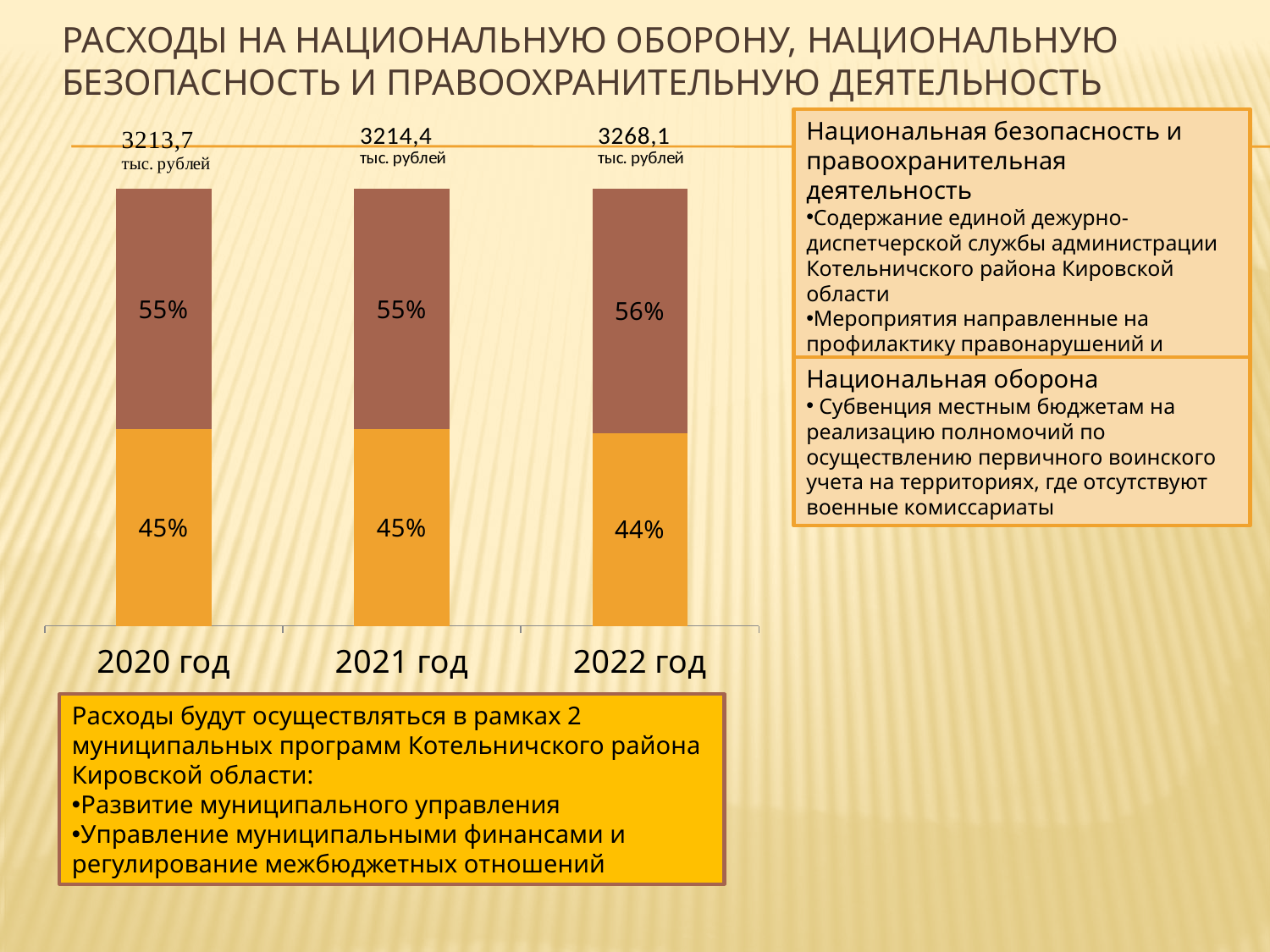
Do the total values printed above the bars rise or fall from 2020 год to 2022 год? Rise By how much does the total printed above the 2022 год bar exceed the total above the 2020 год bar? 54,4 тыс. рублей What kind of chart is shown on the slide? Stacked bar chart Which year has the highest total value printed above its bar? 2022 год What percentage is shown for the brown (top) segment of the 2021 год bar? 55% How many bars (years) are shown in the chart? 3 In the 2022 год bar, what is the difference in percentage points between the brown segment and the orange segment? 12 percentage points Which year has the larger orange (bottom) segment share: 2020 год or 2022 год? 2020 год What percentage is shown for the brown (top) segment of the 2022 год bar? 56% Which year has the lowest total value printed above its bar? 2020 год What total value is printed above the 2021 год bar? 3214,4 тыс. рублей What percentage is shown for the orange (bottom) segment of the 2020 год bar? 45%